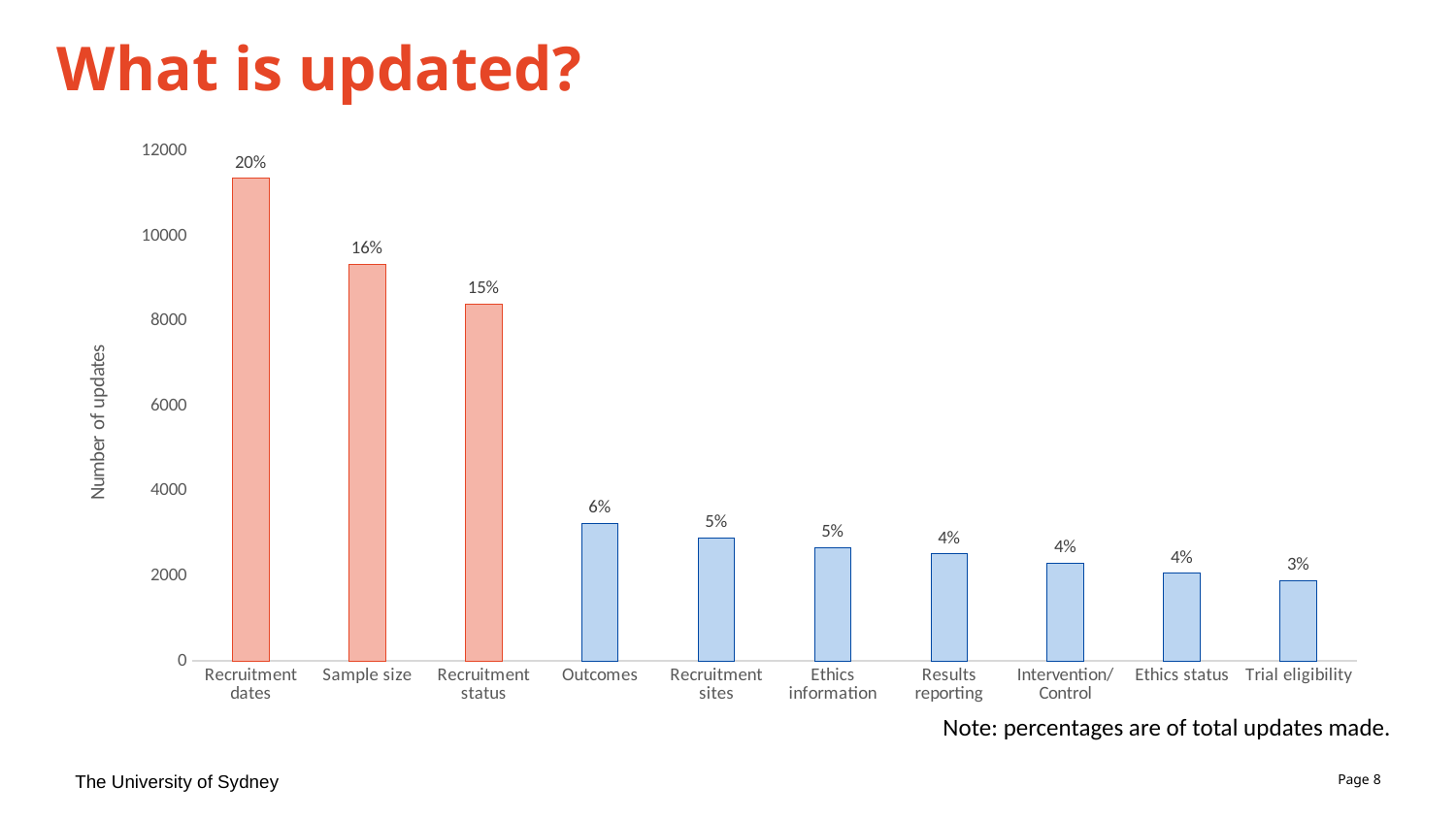
What percentage label is shown on the bar for Sample size? 16% Is the number of updates for Recruitment dates greater or less than 10000? greater What is the label on the vertical axis? Number of updates Which category has the highest number of updates? Recruitment dates Is the number of updates for Sample size greater or less than 10000? less What is the difference in percentage points between the labels for Recruitment dates and Sample size? 4 percentage points Which has more updates, Outcomes or Recruitment sites? Outcomes How many categories are shown on the x axis? 10 What percentage label is shown on the bar for Outcomes? 6% What percentage label is shown on the bar for Recruitment dates? 20% Which category has the lowest number of updates? Trial eligibility What percentage label is shown on the bar for Trial eligibility? 3%